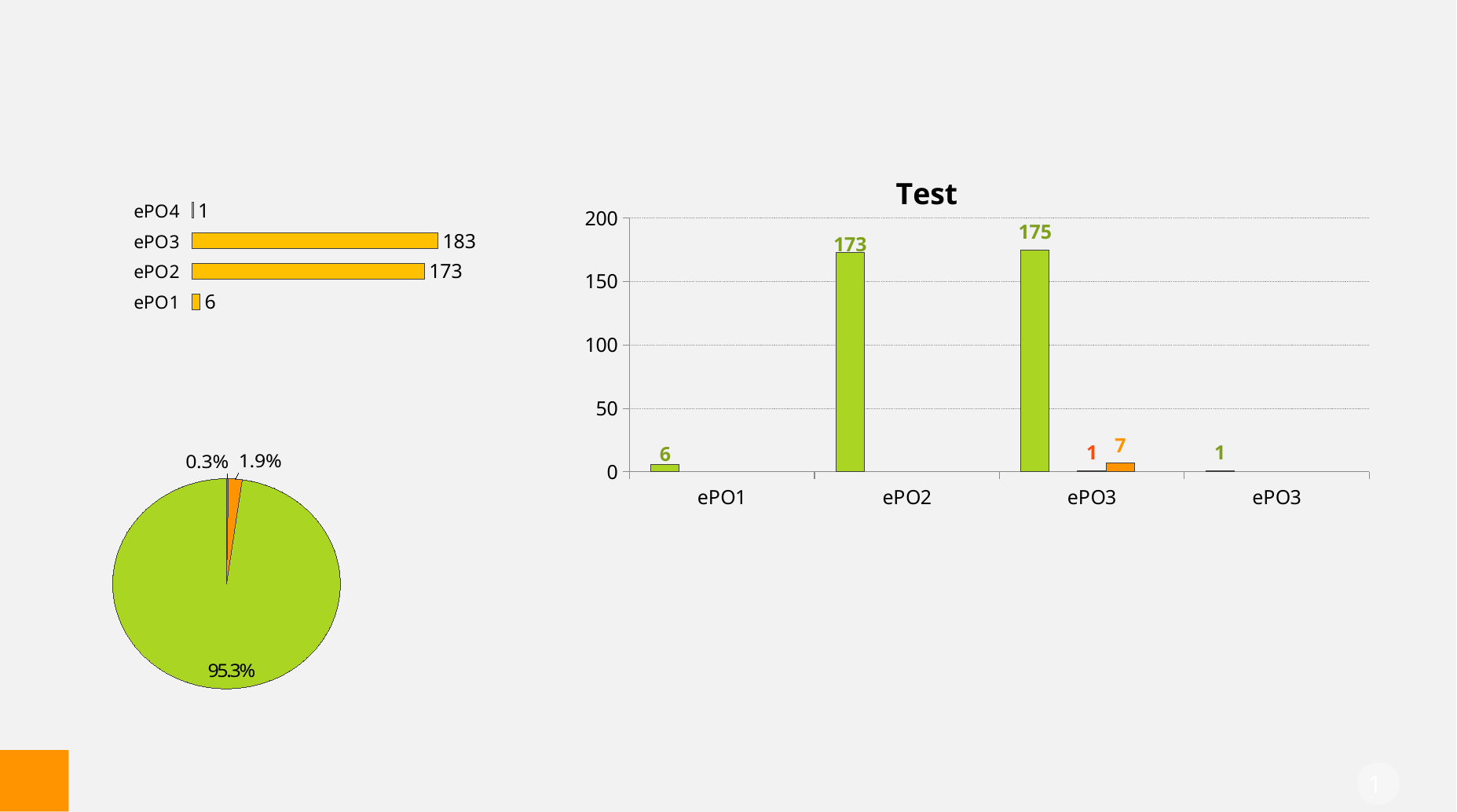
In the chart titled 'Test', what is the value for ePO1? 6 In the pie chart at the bottom left, what is the share of the largest slice? 95.3% In the chart titled 'Test', is the value for ePO2 greater or less than 150? greater How many categories are shown in the top-left bar chart? 4 In the top-left bar chart, what is the difference between the values for ePO3 and ePO2? 10 How many slices does the pie chart at the bottom left have? 3 In the top-left bar chart, what is the value for ePO3? 183 In the chart titled 'Test', what is the value for ePO2? 173 In the top-left bar chart, which category has the lowest value? ePO4 In the top-left bar chart, which category has the highest value? ePO3 What kind of chart is the top-left chart? bar chart In the top-left bar chart, what is the value for ePO1? 6